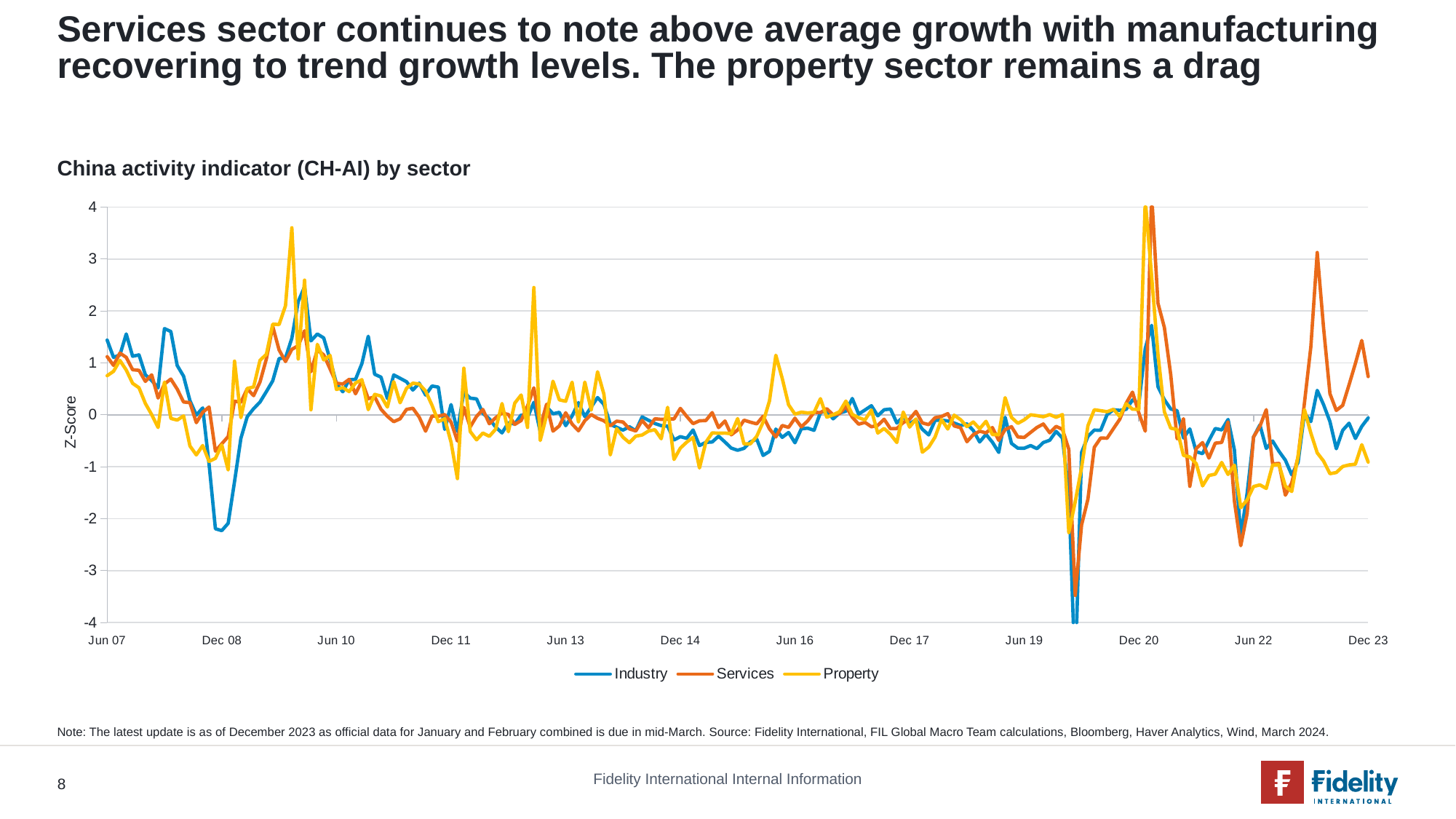
What is the label on the vertical axis of the chart? Z-Score Which series reaches the lowest value in the sharp dip between Jun 19 and Dec 20? Industry What kind of chart is shown on the slide? Line chart How many date labels are shown along the x axis? 12 How many series does the legend list? 3 Is the lowest value of the Industry series between Jun 19 and Dec 20 greater or less than -3? less Is the peak value of the Property series between Dec 08 and Jun 10 greater or less than 3? greater Is the peak value of the Services series around Dec 20 greater or less than 3? greater What is the title of the chart? China activity indicator (CH-AI) by sector Which series reaches the highest value between Dec 08 and Jun 10? Property At Dec 23, which series is higher: Services or Property? Services